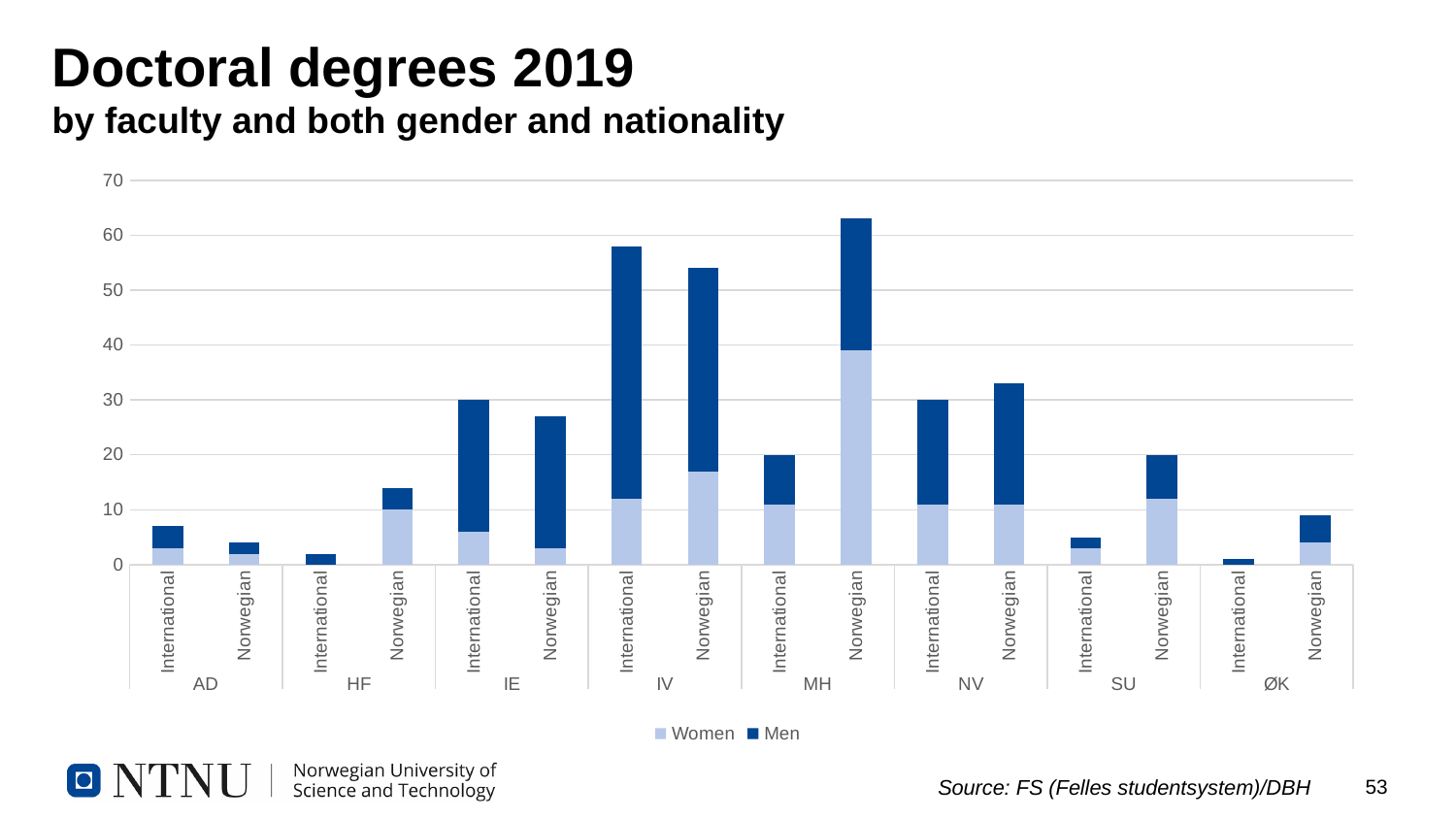
How many faculties are shown along the x axis? 8 Is the total for MH Norwegian greater or less than 60? greater Is the total for MH International greater or less than 30? less What are the two series named in the legend? Women and Men Which bar is the tallest in the chart? MH Norwegian Is the total for IV International greater or less than 50? greater What type of chart is shown on the slide? stacked bar chart Which is larger, the total for MH Norwegian or MH International? MH Norwegian Which is larger, the total for HF Norwegian or HF International? HF Norwegian Which bar is the shortest in the chart? ØK International How many series does the legend list? 2